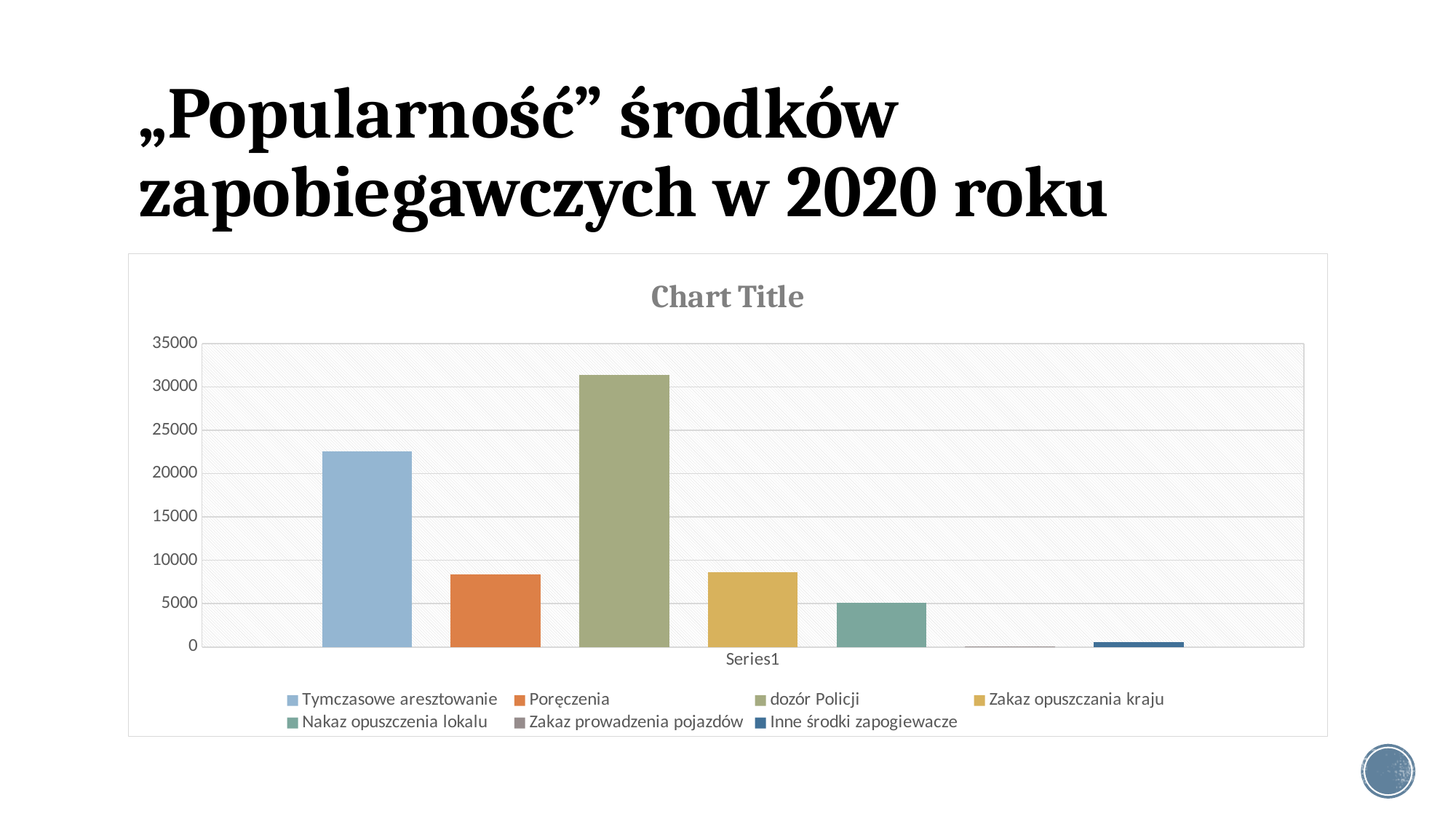
What is the title shown above the chart? Chart Title Which is larger, the value for Tymczasowe aresztowanie or the value for Poręczenia? Tymczasowe aresztowanie Is the value for Poręczenia greater or less than 10000? less What kind of chart is shown on the slide? bar chart Which series has the highest bar? dozór Policji Is the value for Tymczasowe aresztowanie greater or less than 20000? greater Which series has the lowest bar? Zakaz prowadzenia pojazdów Which is larger, the value for dozór Policji or the value for Tymczasowe aresztowanie? dozór Policji How many series does the legend list? 7 Is the value for Inne środki zapogiewacze greater or less than 5000? less What label appears on the x axis below the bars? Series1